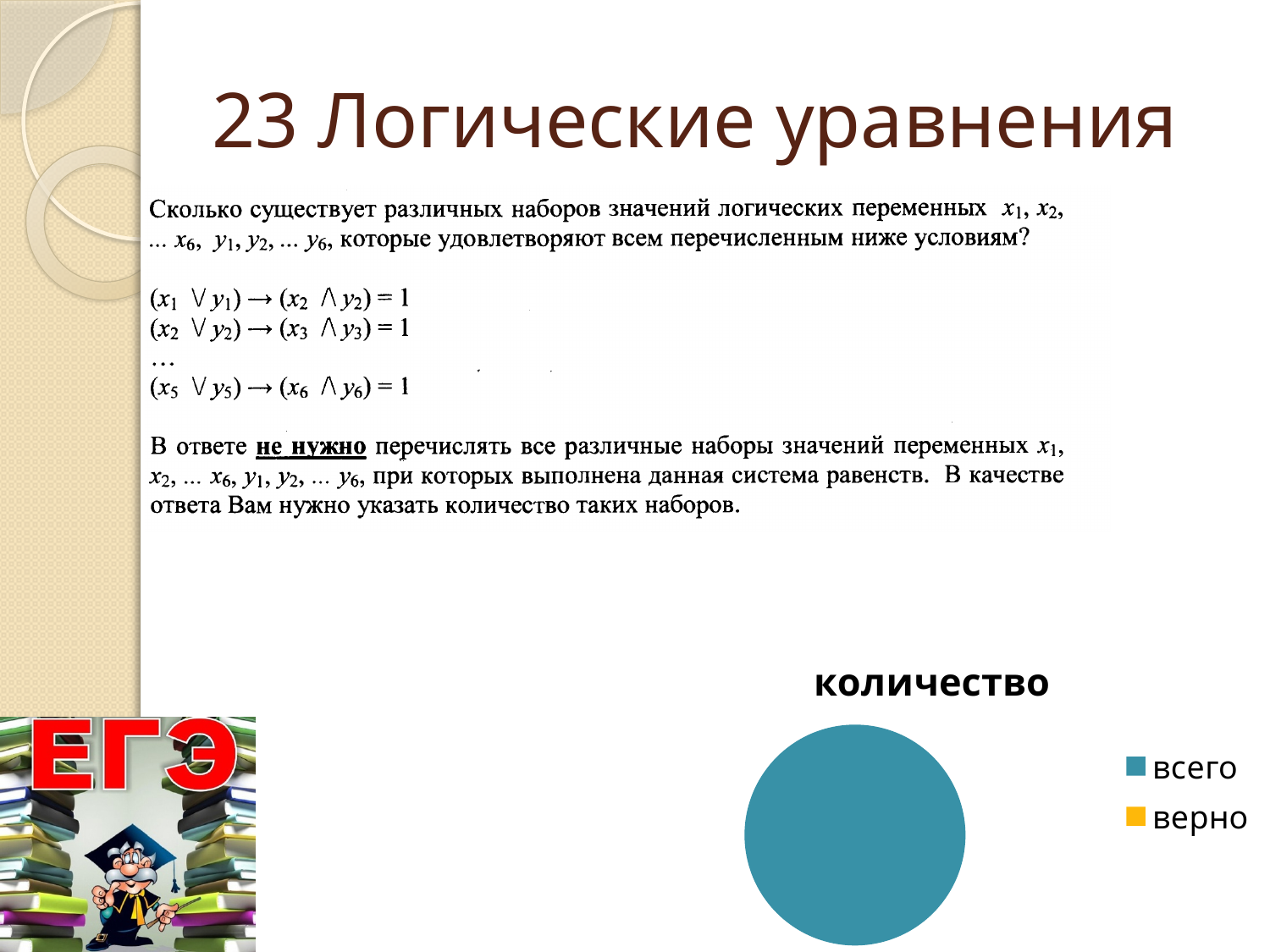
How many entries does the legend of the pie chart list? 2 What kind of chart is shown on the slide? pie chart What colour is the slice for всего in the pie chart? blue Which is larger in the pie chart, всего or верно? всего Which category has the smallest slice in the pie chart? верно Which legend entry is shown in yellow in the pie chart? верно Which category has the largest slice in the pie chart? всего What is the title of the pie chart? количество